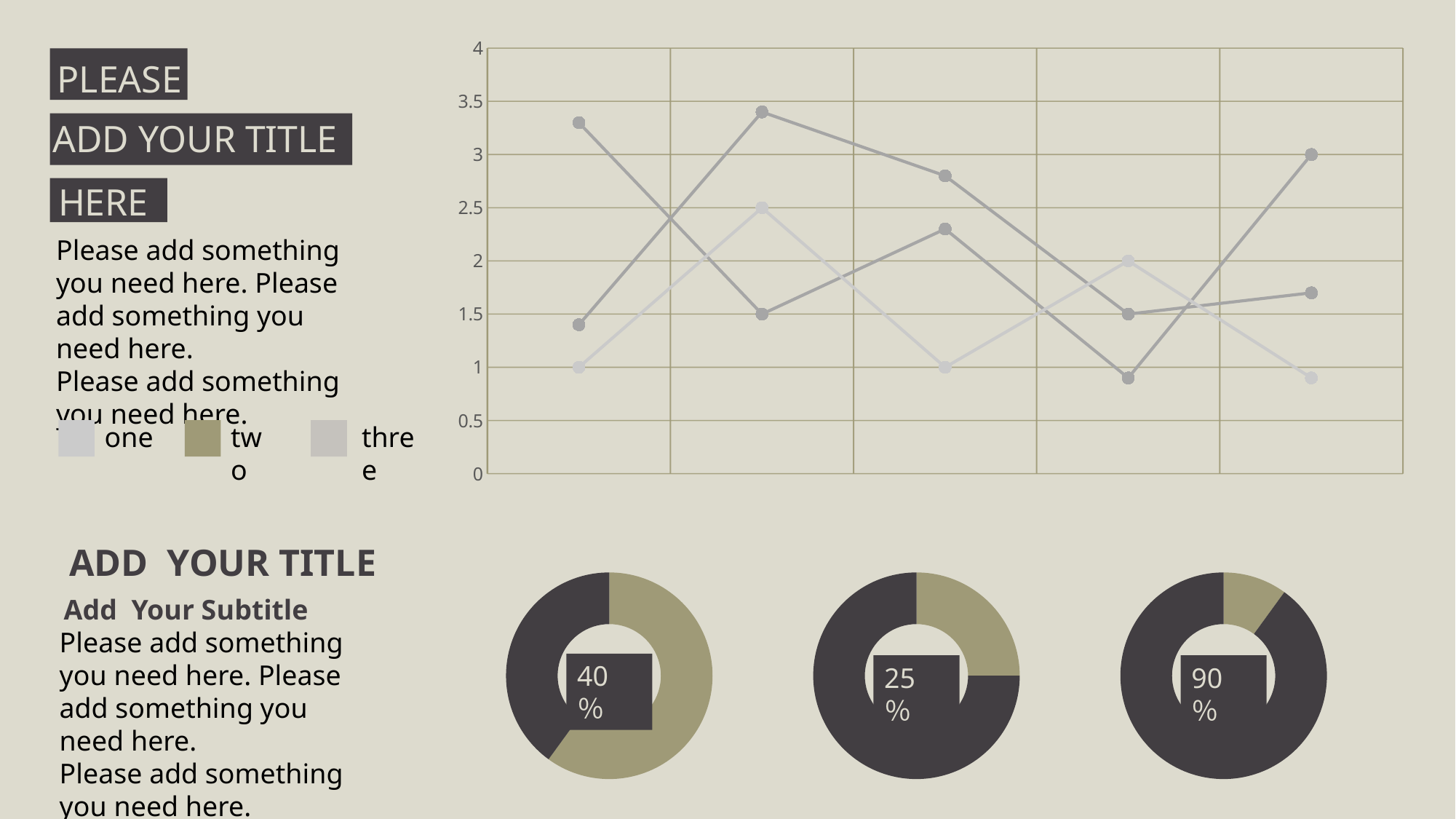
What kind of chart is the chart at the top right of the slide? line chart In the line chart, is the highest plotted point greater or less than 3? greater What are the entries in the legend of the line chart? one, two, three What is the highest value shown on the vertical axis of the line chart? 4 What kind of charts are the three charts at the bottom of the slide? donut (pie) charts How many data points does each line in the line chart have? 5 What percentage is shown in the middle donut chart at the bottom of the slide? 25% How many series does the legend of the line chart list? 3 What percentage is shown in the leftmost donut chart at the bottom of the slide? 40% Which of the three donut charts at the bottom shows the highest percentage? the rightmost one (90%) In the line chart, is the lowest plotted point greater or less than 1? less What is the difference between the percentage in the rightmost donut chart and the percentage in the leftmost donut chart? 50 percentage points